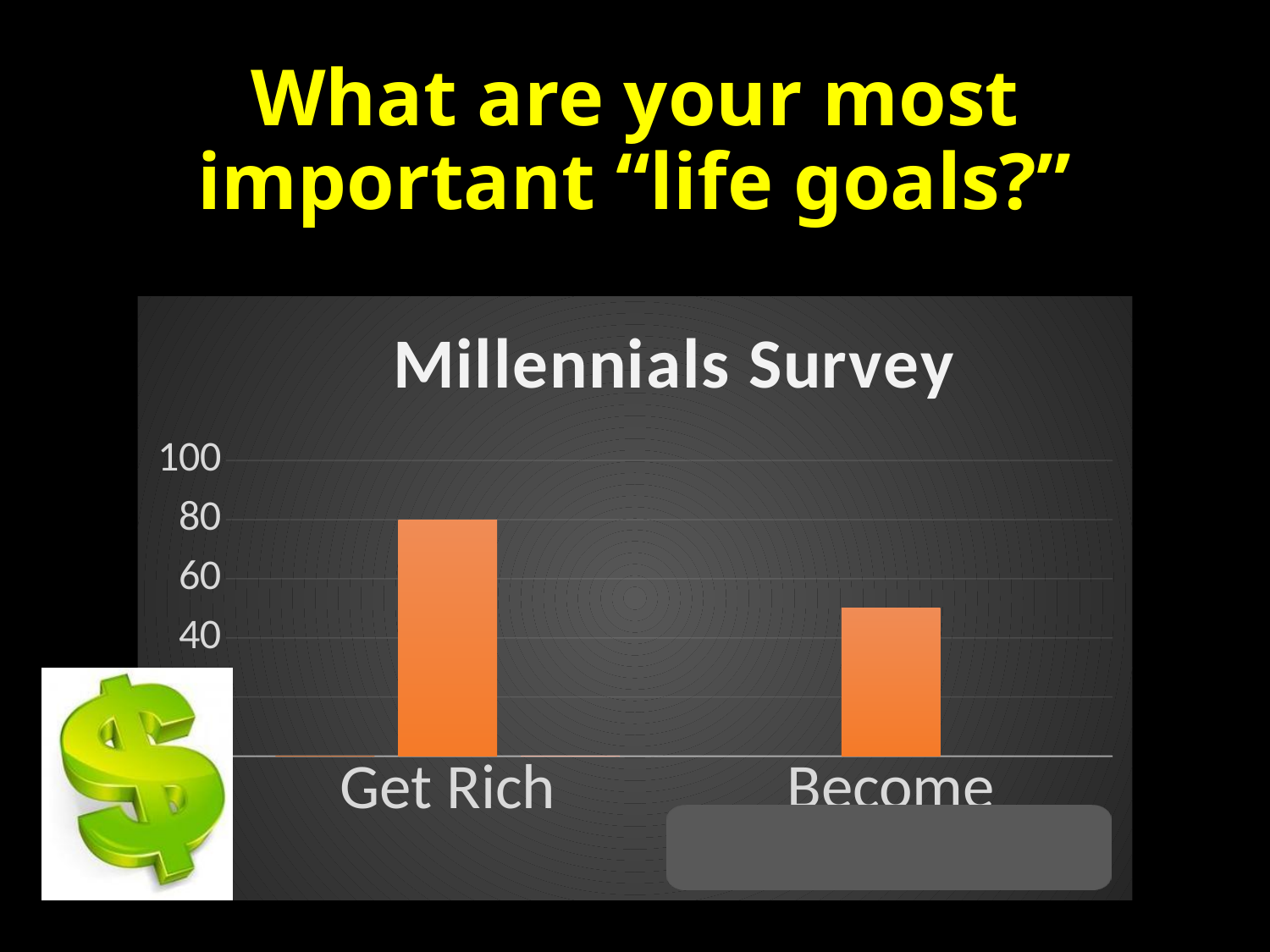
Is the value for Get Rich greater or less than 100? less Is the value for Get Rich larger or smaller than the value for the second bar labelled 'Become'? larger Which category has the highest value in the Millennials Survey chart? Get Rich What is the title of the chart? Millennials Survey Do the bar values rise or fall from left to right in the Millennials Survey chart? fall What is the value for Get Rich in the Millennials Survey chart? 80 Which bar is lower in the Millennials Survey chart, Get Rich or the second bar labelled 'Become'? Become What kind of chart is shown on the slide? bar chart Is the value for the second bar (labelled 'Become') greater or less than 40? greater Is the value for the second bar (labelled 'Become') greater or less than 60? less What colour are the bars in the Millennials Survey chart? orange How many bars are plotted in the Millennials Survey chart? 2